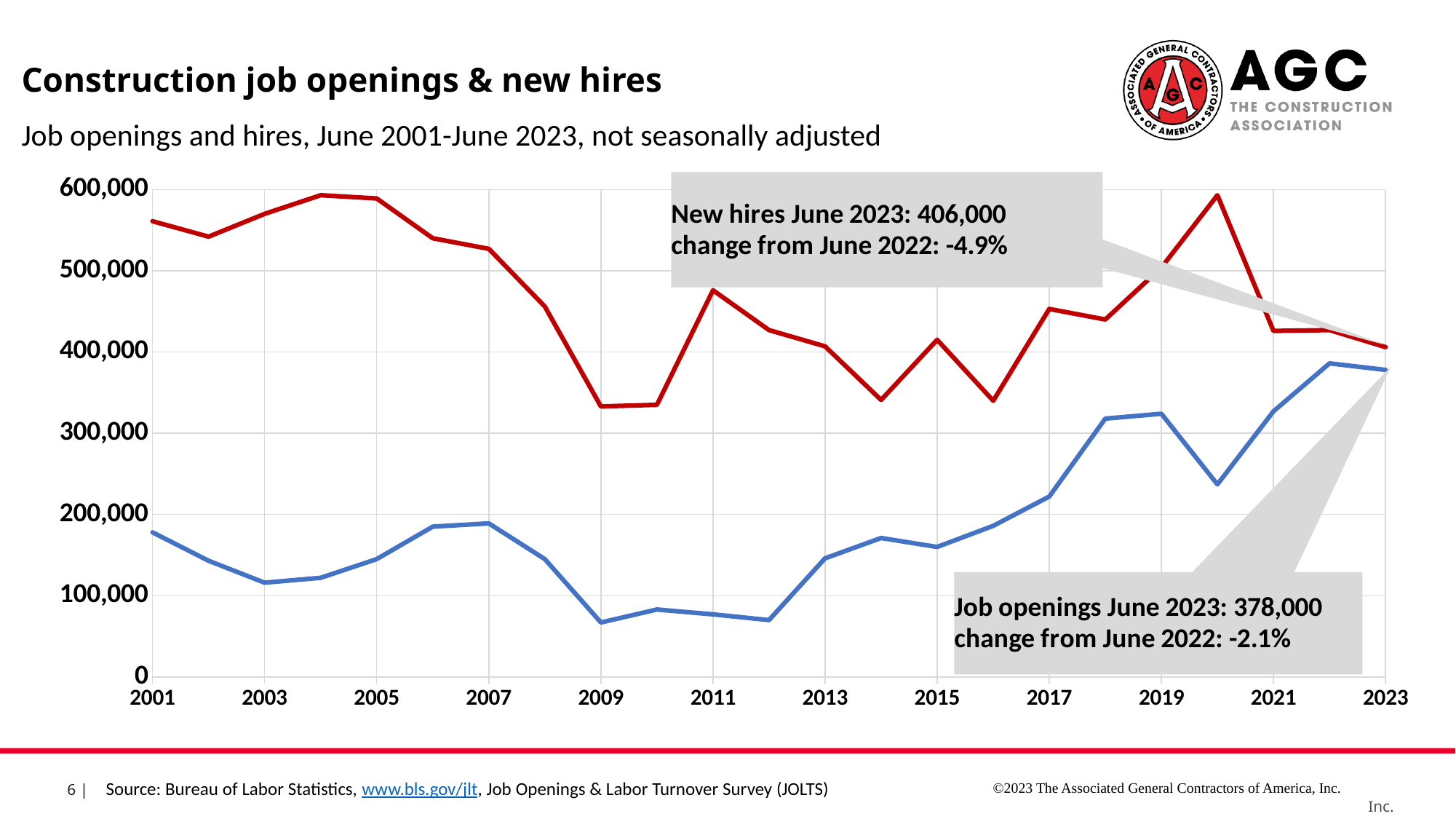
Is the value for new hires in 2004 greater or less than 500,000? greater What is the difference between new hires and job openings in June 2023? 28,000 Is the value for job openings in 2022 greater or less than 300,000? greater Is the value for job openings in 2009 greater or less than 100,000? less Do job openings rise or fall from 2017 to 2019? Rise In June 2023, which is larger: new hires or job openings? New hires Do new hires rise or fall from 2020 to 2023? Fall What is the change in new hires from June 2022 to June 2023, as stated on the slide? -4.9% What kind of chart is shown on the slide? Line chart What is the value of new hires in June 2023? 406,000 What is the change in job openings from June 2022 to June 2023, as stated on the slide? -2.1% What is the value of job openings in June 2023? 378,000